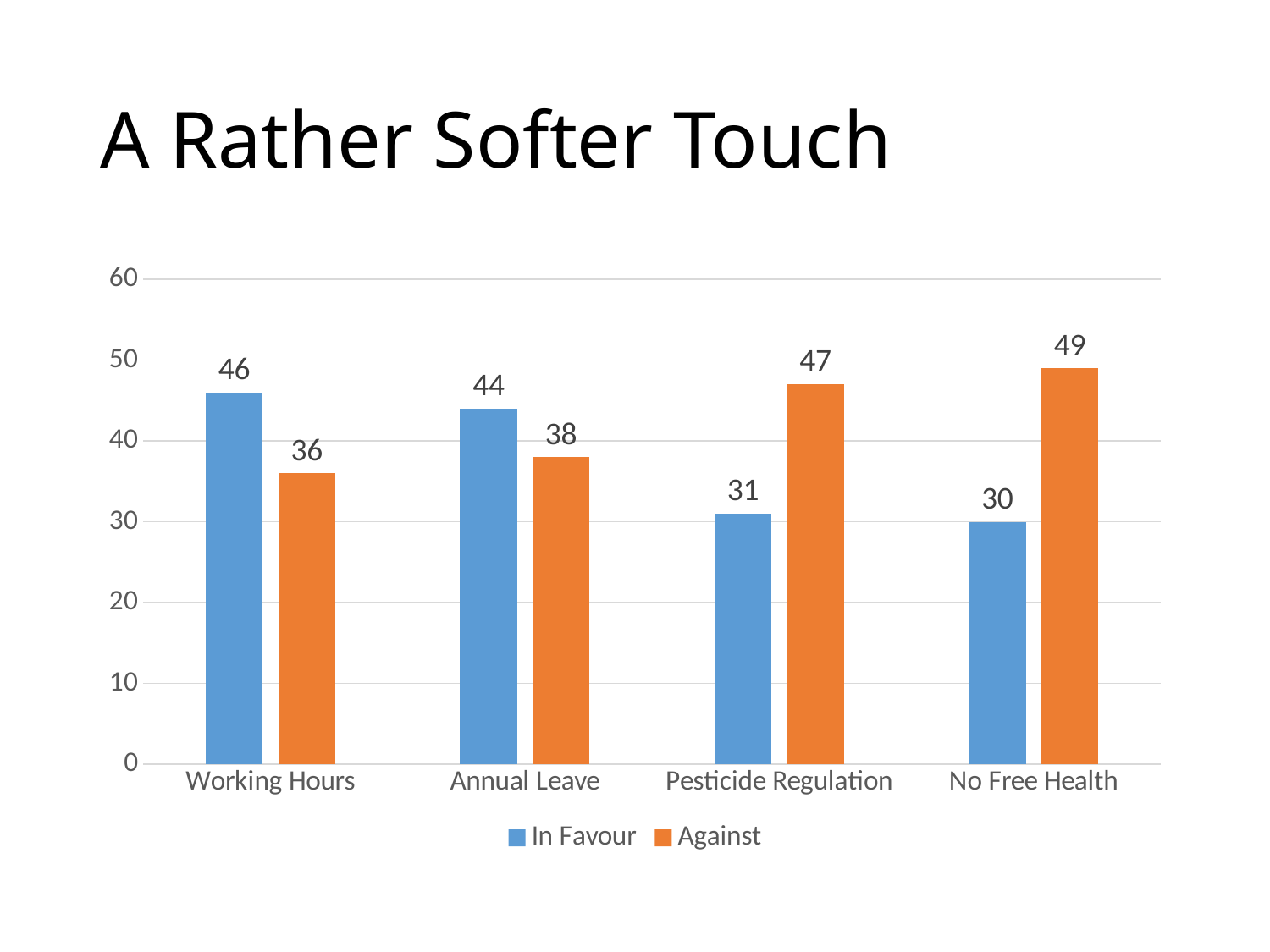
How many series does the legend list? 2 What is the Against value for Pesticide Regulation? 47 Which is larger for Working Hours, In Favour or Against? In Favour What is the In Favour value for Working Hours? 46 What is the difference between the In Favour and Against values for Annual Leave? 6 What is the title of the slide? A Rather Softer Touch Is the Against value for No Free Health greater or less than 40? greater Which category has the highest Against value? No Free Health Which category has the lowest In Favour value? No Free Health What is the In Favour value for No Free Health? 30 What kind of chart is shown on the slide? Bar chart How many categories are shown on the x axis? 4